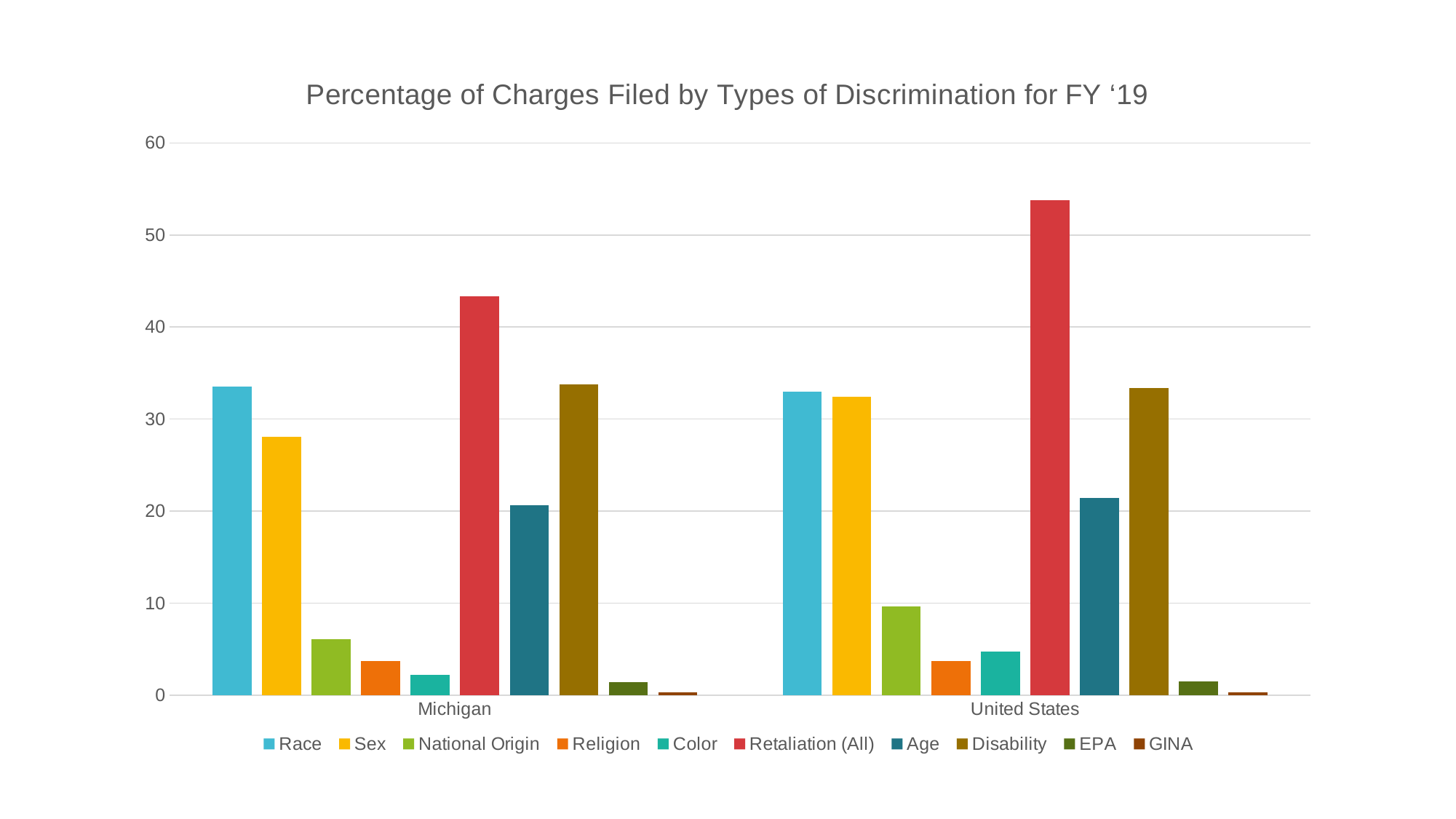
Is the Retaliation (All) value for the United States greater or less than 50? greater What is the title of the chart? Percentage of Charges Filed by Types of Discrimination for FY ‘19 Which type of discrimination has the highest percentage for Michigan? Retaliation (All) How many categories are shown on the x axis? 2 Is the Retaliation (All) value for Michigan greater or less than 40? greater Which type of discrimination has the highest percentage for the United States? Retaliation (All) What kind of chart is shown on the slide? bar chart Is the Sex value for Michigan greater or less than 30? less Which type of discrimination has the lowest percentage for Michigan? GINA Which is larger, the Sex value for Michigan or the Sex value for the United States? United States How many series does the legend list? 10